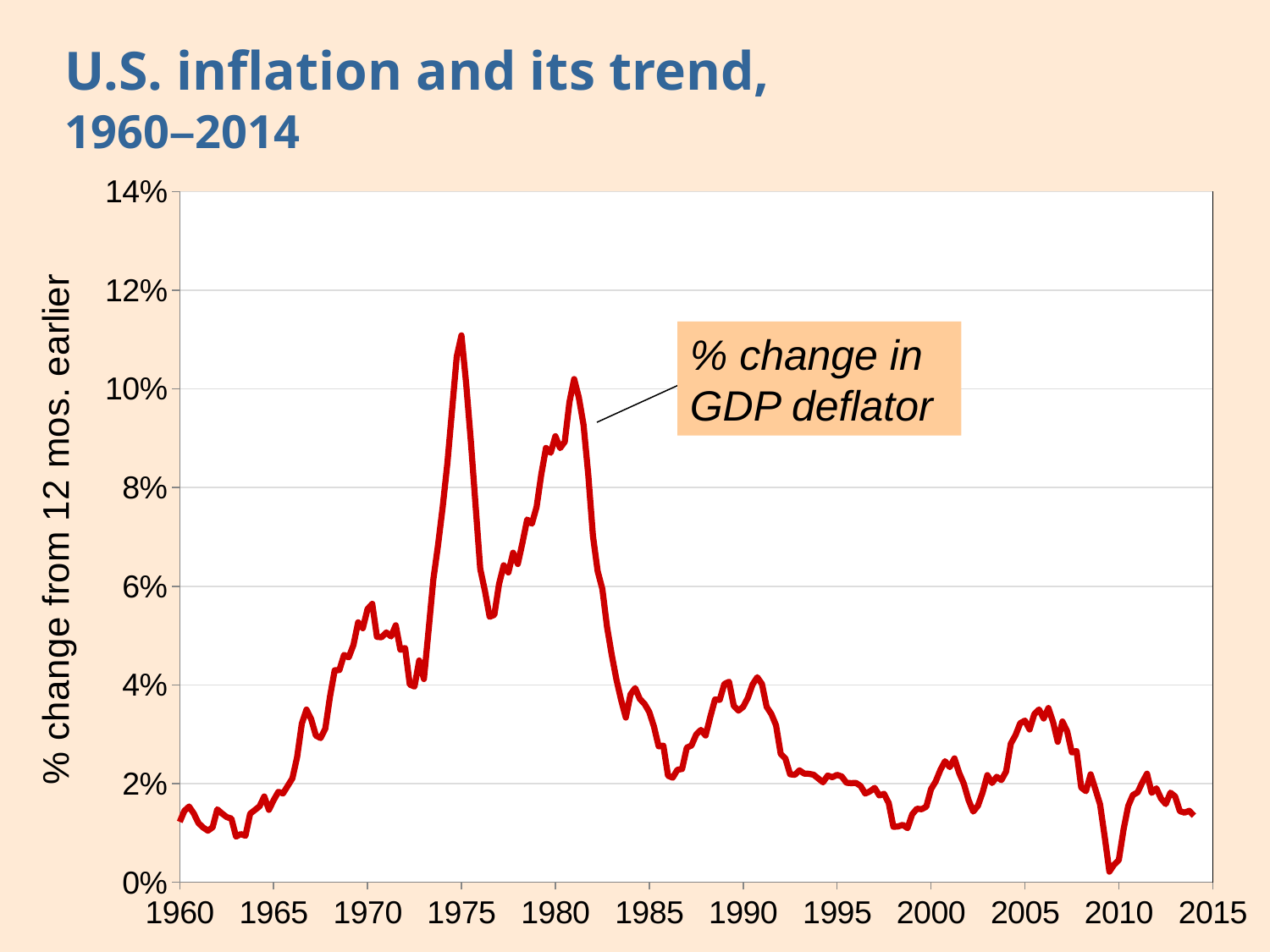
Around which year does the line reach its lowest value? 2010 What label is given to the plotted line in the callout box? % change in GDP deflator Is the value for 1990 greater or less than 6%? less What kind of chart is shown on the slide? Line chart How many lines are plotted on the chart? 1 Around which year does the line reach its highest value? 1975 Is the value for 1960 greater or less than 2%? less Is the value for 1975 greater or less than 10%? greater What is the title of the chart on the slide? U.S. inflation and its trend, 1960–2014 Which is higher, the peak around 1975 or the peak around 1981? The peak around 1975 Does the line rise or fall between 1981 and 1986? Fall